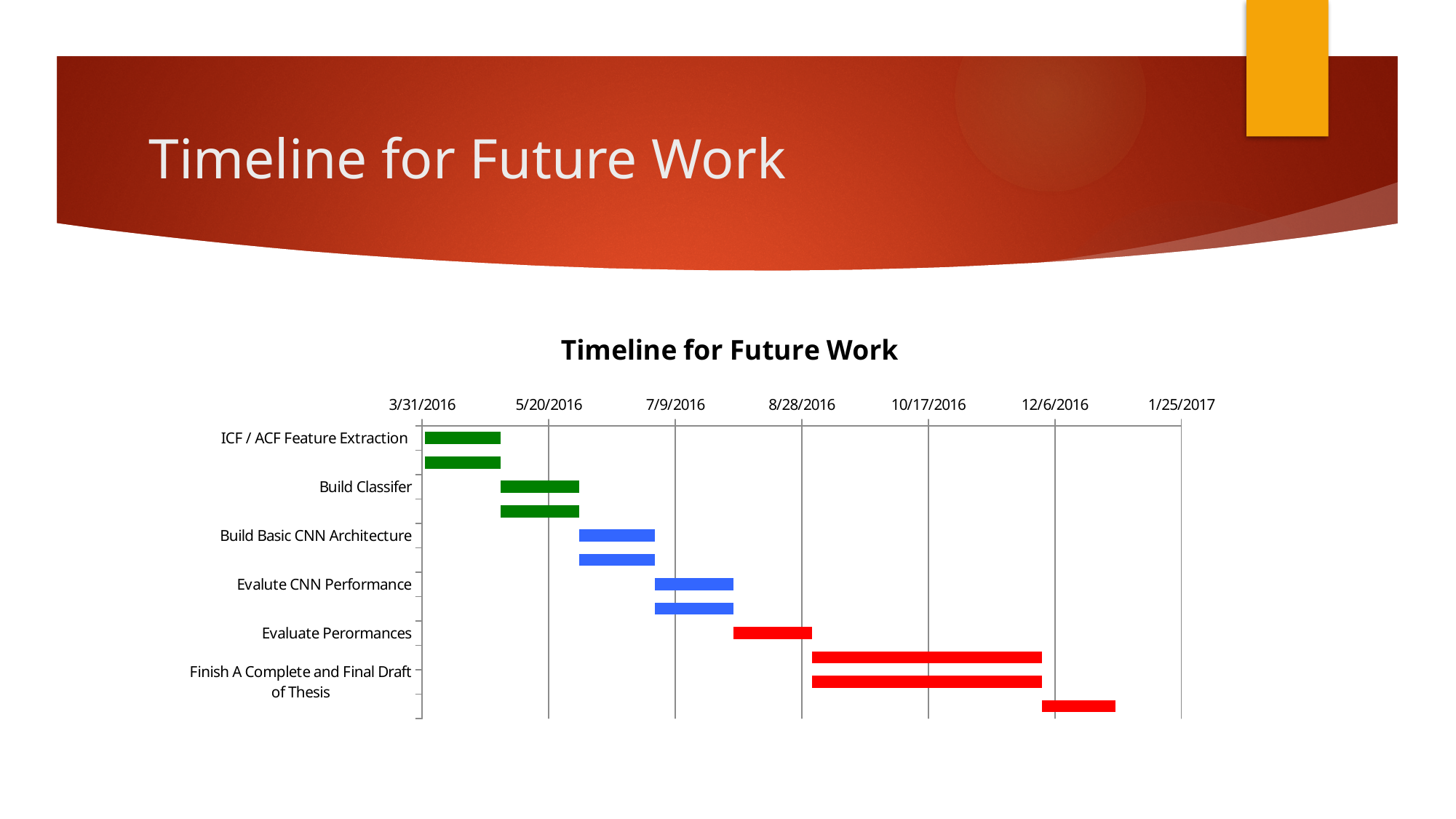
Which task starts earliest on the timeline? ICF / ACF Feature Extraction What is the earliest date shown on the horizontal axis? 3/31/2016 How many task categories are labelled on the vertical axis of the chart? 6 Does the ICF / ACF Feature Extraction task end before or after 5/20/2016? before Does the Build Basic CNN Architecture task start before or after 5/20/2016? after What kind of chart is shown on the slide? Bar chart (Gantt-style horizontal bar chart) Which labelled task has the longest bar on the timeline? Finish A Complete and Final Draft of Thesis What is the title of the chart? Timeline for Future Work Does the Evalute CNN Performance task start before or after 7/9/2016? before Which task starts later, Build Classifer or Build Basic CNN Architecture? Build Basic CNN Architecture Do the tasks start progressively later moving down the vertical axis? Yes